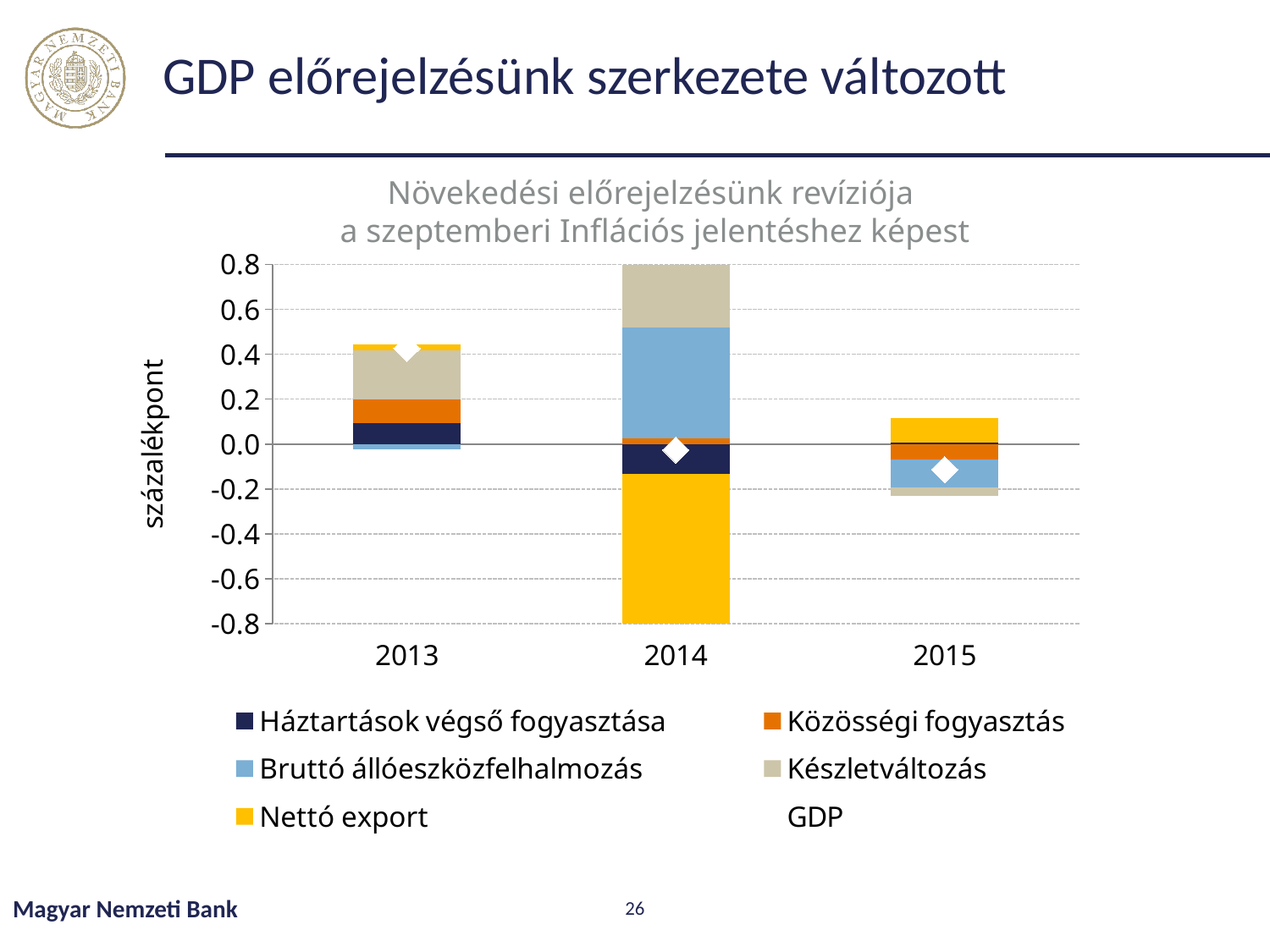
Is the GDP marker for 2015 greater or less than 0.0? less What is the label of the vertical axis? százalékpont Is the GDP marker for 2013 greater or less than 0.2? greater Which year has the lowest GDP marker? 2015 Which year has the highest GDP marker? 2013 How many entries does the legend list? 6 What is the title of the chart? Növekedési előrejelzésünk revíziója a szeptemberi Inflációs jelentéshez képest Is the Nettó export value for 2014 greater or less than -0.4? less How many years (categories) are shown on the x axis? 3 Is the GDP marker higher for 2013 or for 2015? 2013 What kind of chart is shown on the slide? stacked bar chart